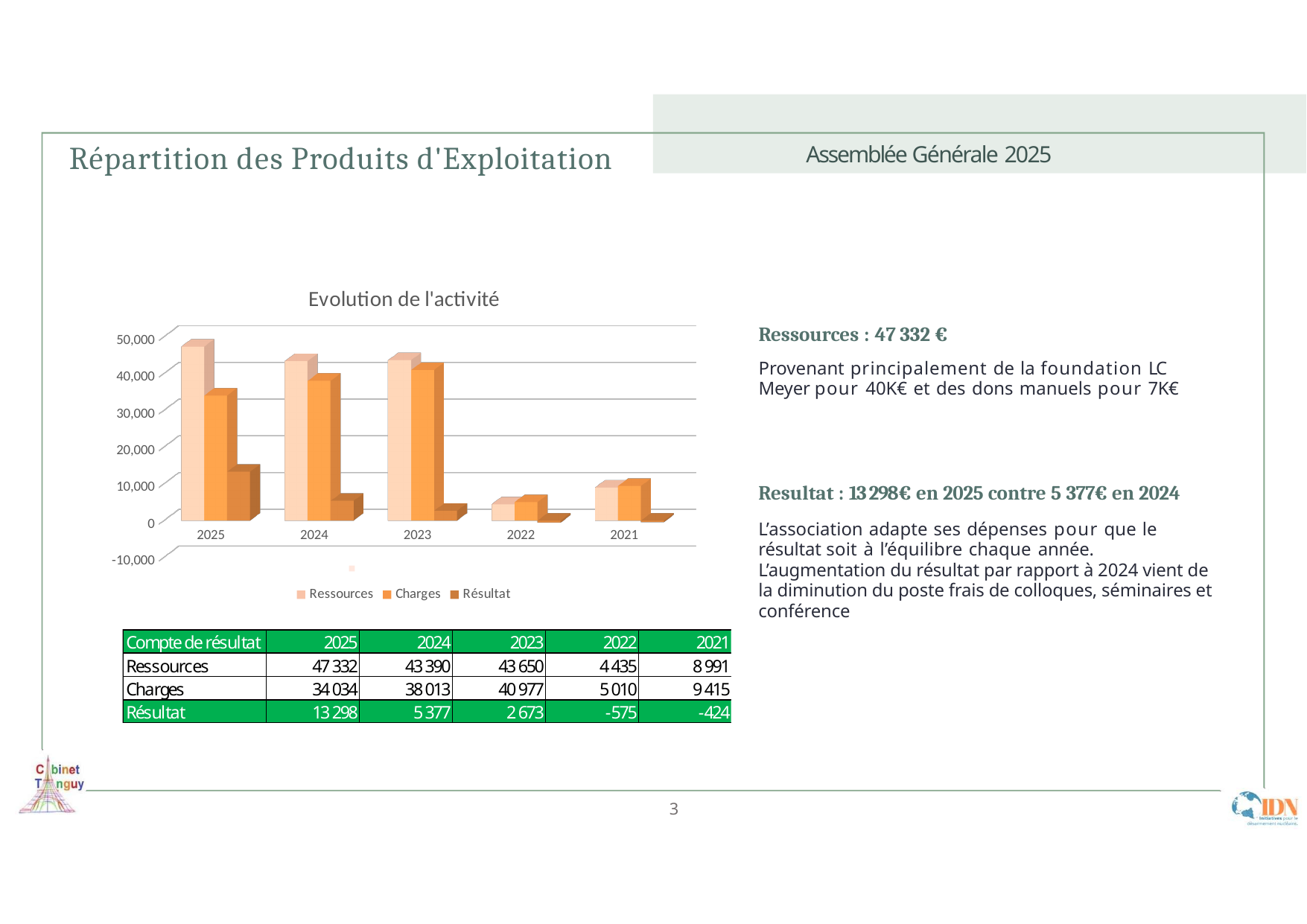
In which year is Ressources the highest? 2025 Do the Résultat values rise or fall along the x axis from 2025 to 2023? fall Which is larger, Charges in 2024 or Charges in 2023? Charges in 2023 What is the Résultat for 2021? -424 What is the difference between Ressources in 2025 and Ressources in 2024? 3 942 In which year is Résultat the lowest? 2022 What kind of chart is "Evolution de l'activité"? bar chart What is the value of Charges for 2023? 40 977 How many years are shown on the x axis of the "Evolution de l'activité" chart? 5 What is the value of Ressources for 2025? 47 332 Is the value of Ressources for 2025 greater or less than 40,000? greater How many series does the legend of the "Evolution de l'activité" chart list? 3